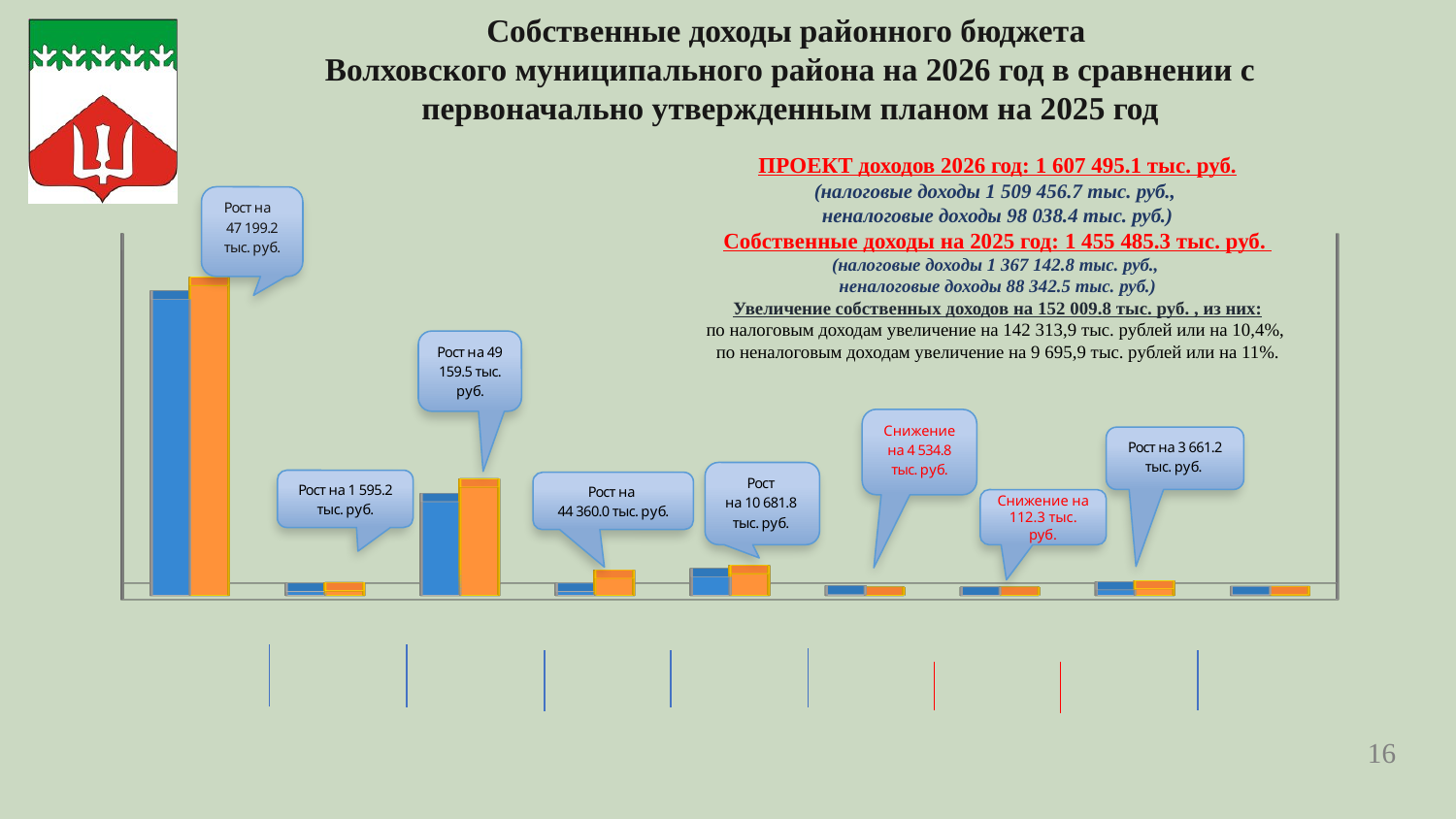
How many bars are there in each group of the chart? 2 What growth amount does the callout above the leftmost group of bars state? Рост на 47 199.2 тыс. руб. How many groups of bars are plotted in the chart? 9 What decrease amount does the callout above the sixth group of bars from the left state? Снижение на 4 534.8 тыс. руб. What kind of chart is shown on the slide? bar chart What growth amount does the callout above the third group of bars from the left state? Рост на 49 159.5 тыс. руб. In the leftmost group of bars, which bar is taller, the blue one or the orange one? the orange one In the third group of bars from the left, which bar is taller, the blue one or the orange one? the orange one What two colours are used for the bars in the chart? blue and orange How many callouts on the chart indicate a decrease (Снижение)? 2 Which group of bars is the tallest in the chart? the leftmost group